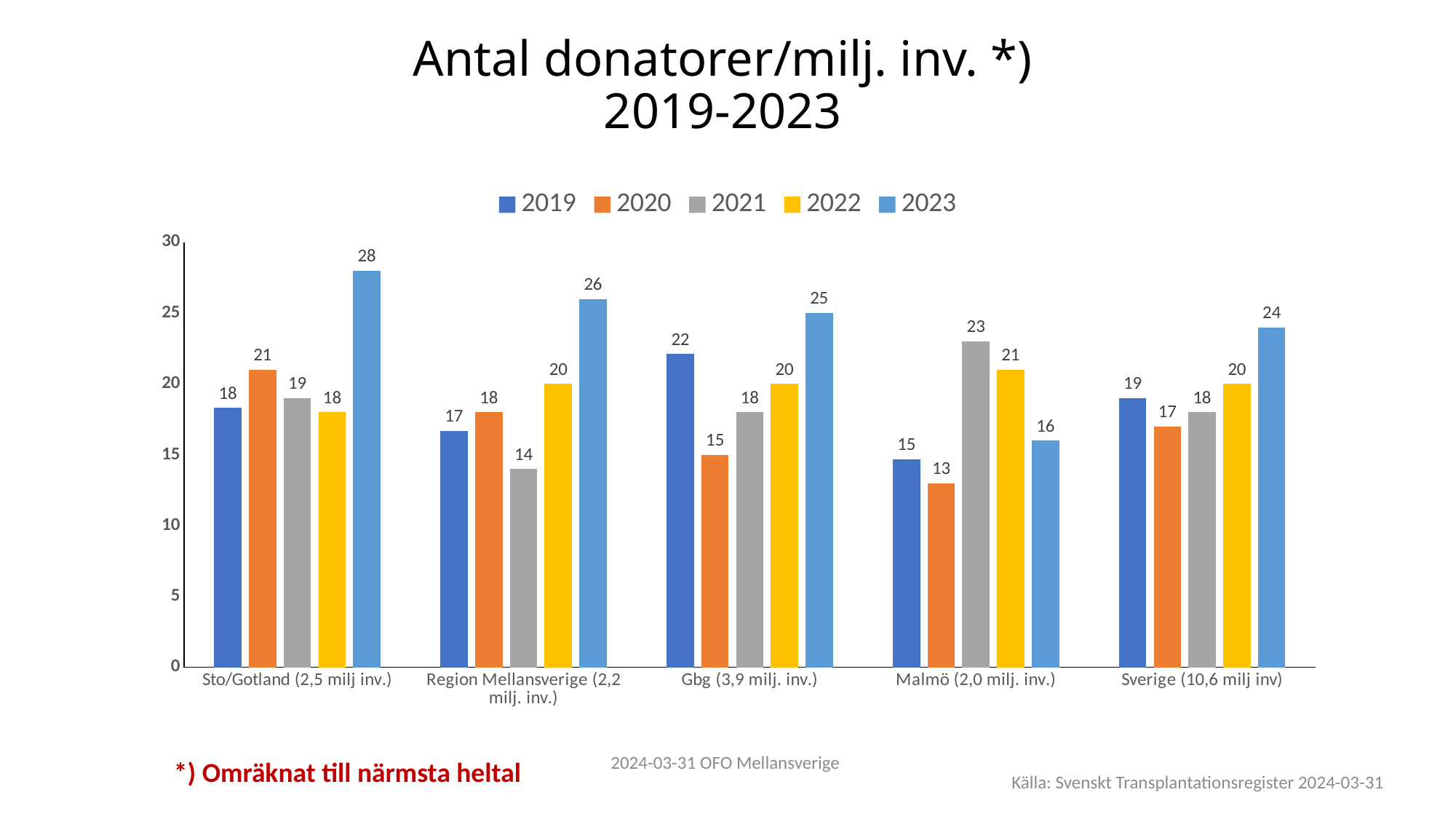
What kind of chart is shown on the slide? bar chart What is the value for Malmö (2,0 milj. inv.) in 2021? 23 How many categories are shown on the x axis? 5 Which is larger for Gbg (3,9 milj. inv.): the 2019 value or the 2020 value? 2019 How many series does the legend list? 5 What is the difference between the 2023 and 2019 values for Region Mellansverige (2,2 milj. inv.)? 9 Which category has the lowest value in 2021? Region Mellansverige (2,2 milj. inv.) Which category has the highest value in 2023? Sto/Gotland (2,5 milj inv.) What is the value for Sto/Gotland (2,5 milj inv.) in 2023? 28 What is the title of the chart? Antal donatorer/milj. inv. *) 2019-2023 Is the value for Malmö (2,0 milj. inv.) in 2020 greater or less than 15? less What is the value for Sverige (10,6 milj inv) in 2020? 17